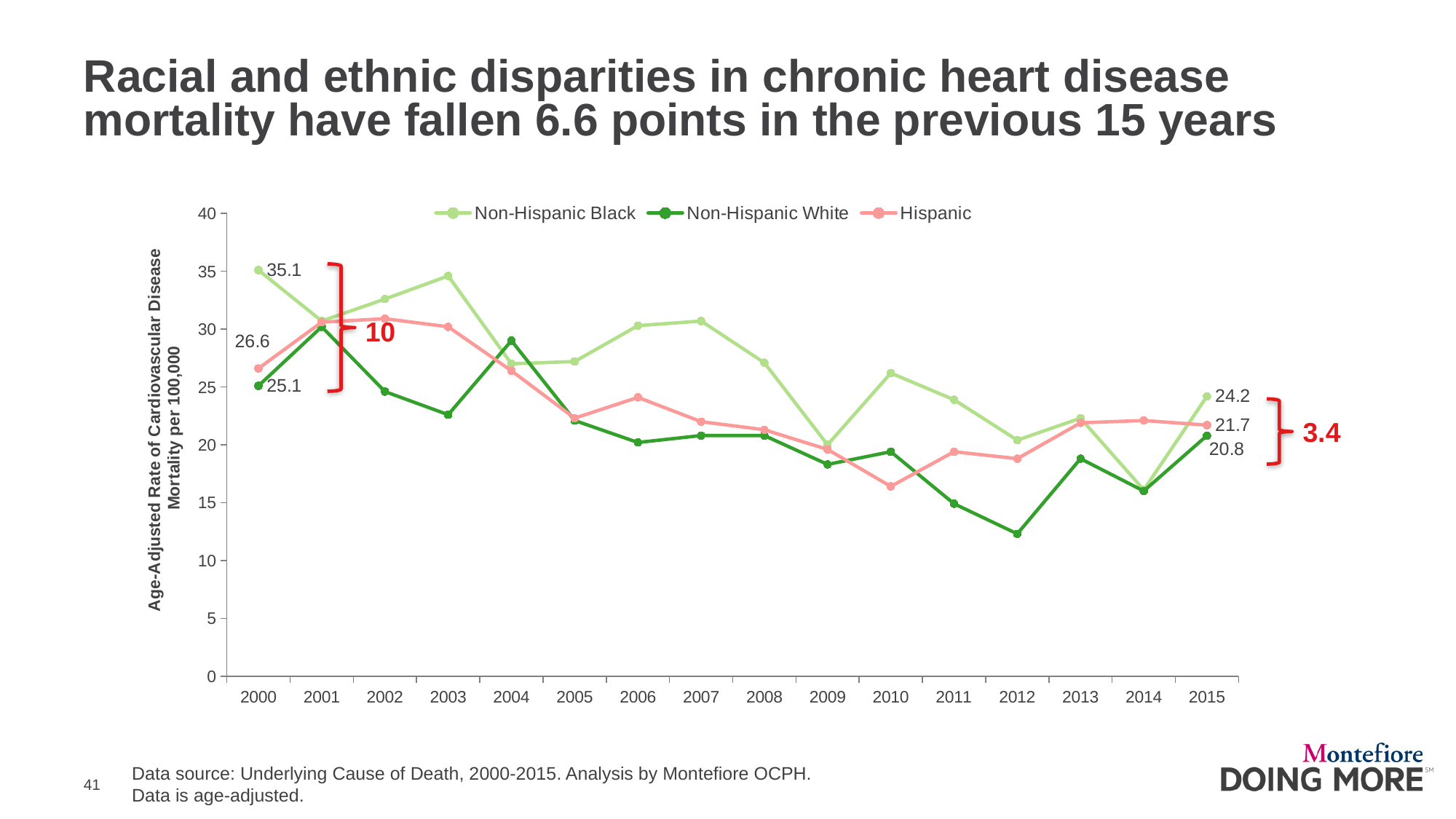
What was the rate for Hispanic in 2015? 21.7 Which series had the highest rate in 2000? Non-Hispanic Black What type of chart is shown on the slide? line chart What was the rate for Non-Hispanic White in 2000? 25.1 What was the age-adjusted cardiovascular disease mortality rate for Non-Hispanic Black in 2000? 35.1 What was the rate for Hispanic in 2000? 26.6 Is the Non-Hispanic White rate in 2012 greater or less than 15? less What is the difference between the Non-Hispanic Black and Non-Hispanic White rates in 2015? 3.4 What is the difference between the Non-Hispanic Black and Non-Hispanic White rates in 2000? 10 How many series does the legend list? 3 What was the rate for Non-Hispanic Black in 2015? 24.2 What was the rate for Non-Hispanic White in 2015? 20.8